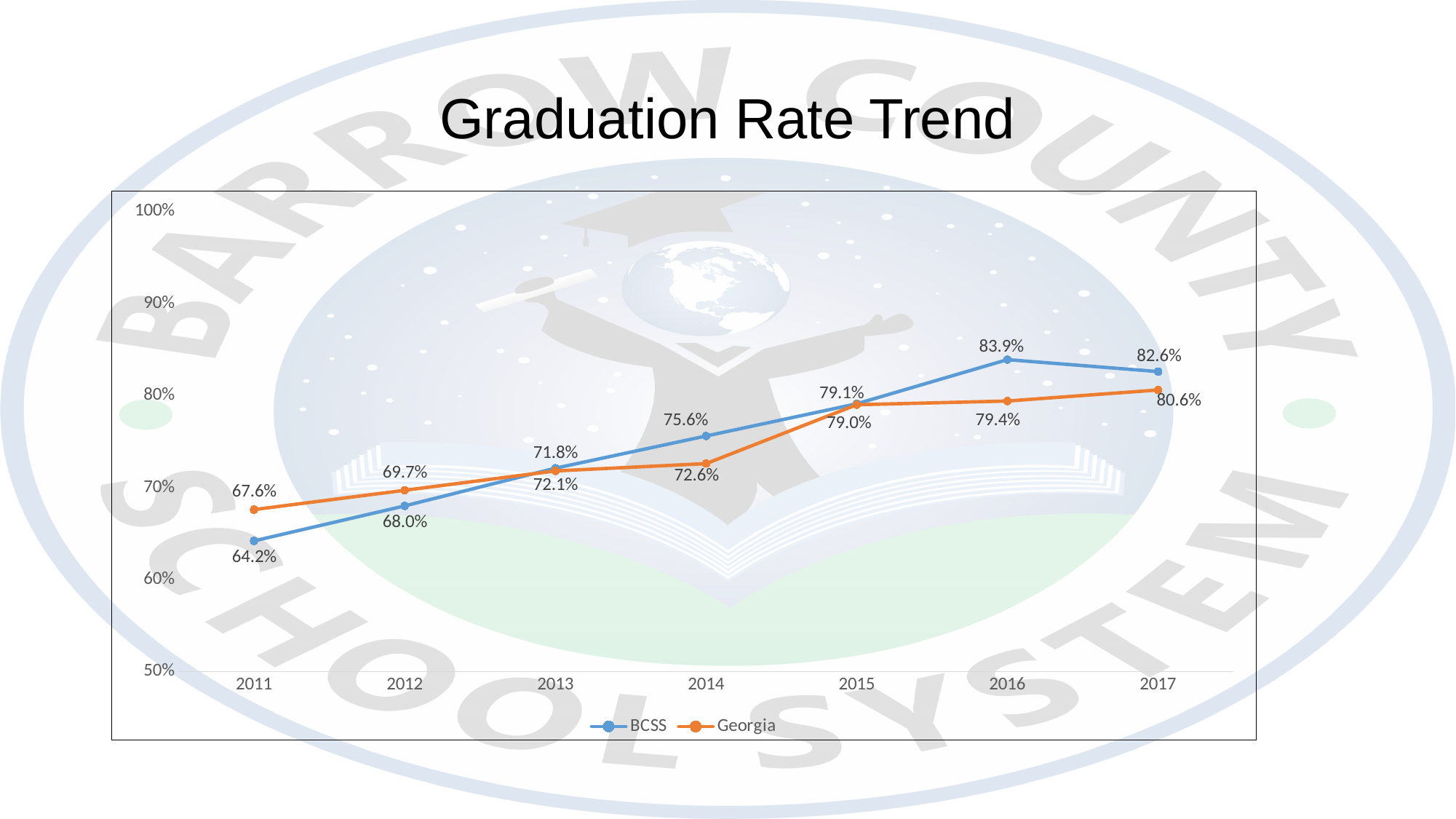
In 2012, which had the higher graduation rate, BCSS or Georgia? Georgia What was the Georgia graduation rate in 2011? 67.6% Did the Georgia graduation rate rise or fall from 2011 to 2017? Rise How many years are shown on the x axis? 7 What kind of chart is shown on the slide? Line chart What was the BCSS graduation rate in 2014? 75.6% In which year was the Georgia graduation rate lowest? 2011 What was the Georgia graduation rate in 2017? 80.6% What is the difference between the BCSS and Georgia graduation rates in 2016? 4.5% How many series does the legend list? 2 In which year was the BCSS graduation rate highest? 2016 What was the BCSS graduation rate in 2016? 83.9%